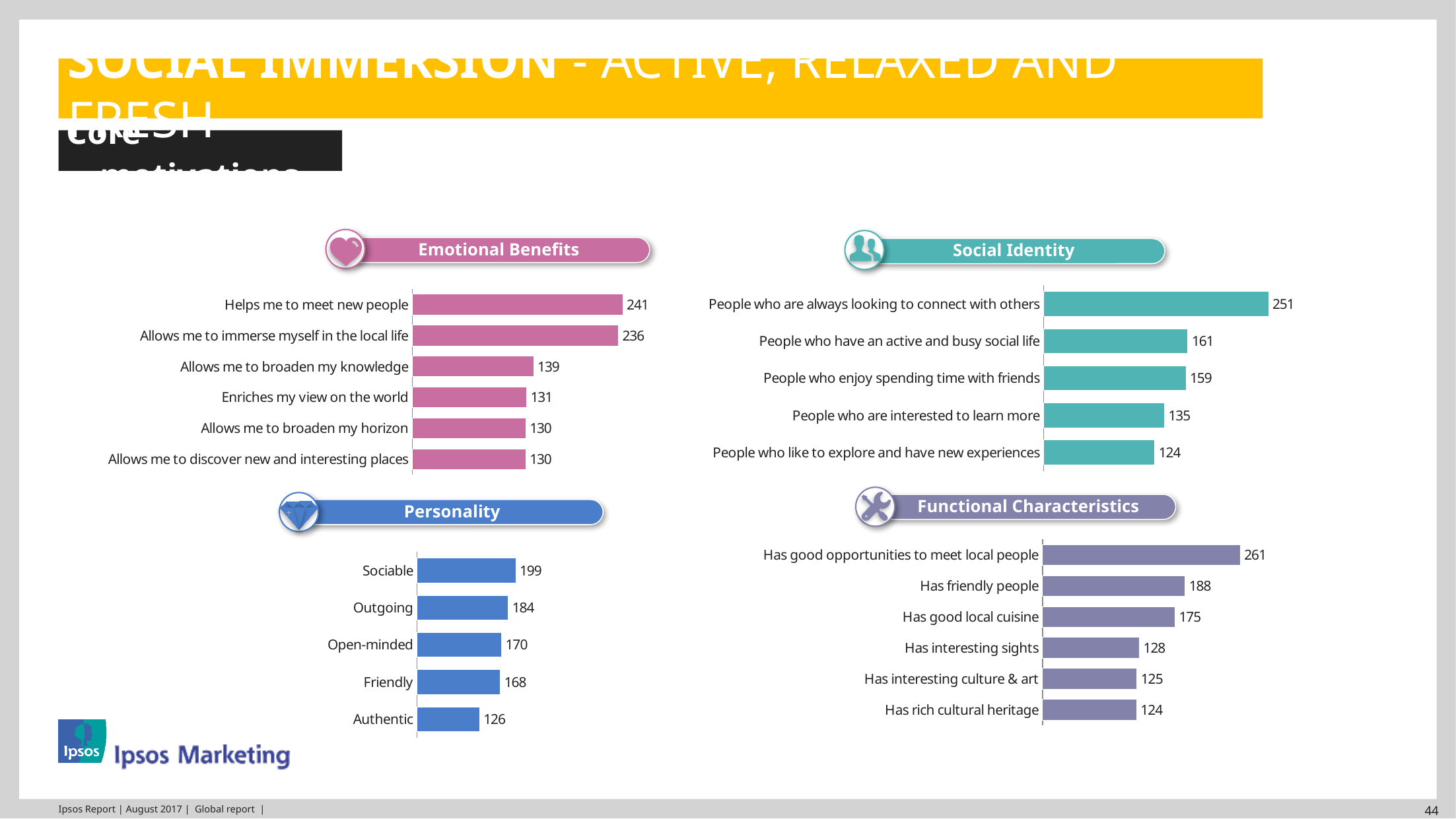
In the Personality chart, what is the difference between Sociable and Outgoing? 15 In the Personality chart, which is larger, Sociable or Authentic? Sociable In the Emotional Benefits chart, what is the value for "Helps me to meet new people"? 241 In the Social Identity chart, which category has the highest value? People who are always looking to connect with others In the Functional Characteristics chart, which category has the lowest value? Has rich cultural heritage In the Social Identity chart, how many categories are shown? 5 In the Functional Characteristics chart, what is the value for "Has friendly people"? 188 In the Personality chart, what is the value for "Open-minded"? 170 In the Emotional Benefits chart, which category has the lowest value? Allows me to broaden my horizon and Allows me to discover new and interesting places (both 130) In the Social Identity chart, what is the value for "People who are interested to learn more"? 135 What type of chart is the Functional Characteristics chart? Bar chart In the Emotional Benefits chart, what is the difference between "Helps me to meet new people" and "Allows me to broaden my knowledge"? 102